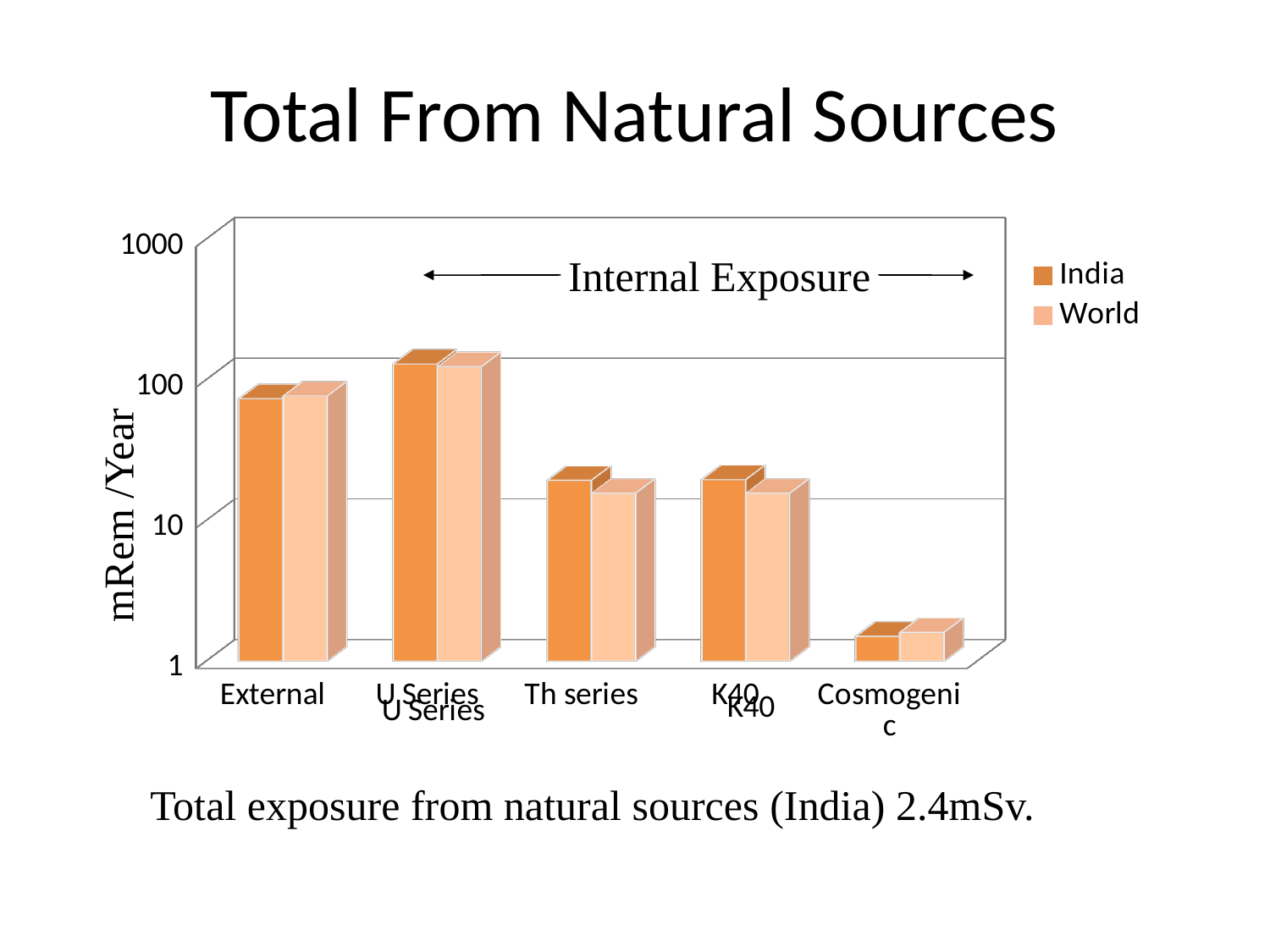
How many categories are shown on the x axis of the chart? 5 For the India series, which is larger: External or Th series? External Is the India value for U Series greater or less than 100? greater Is the India value for External greater or less than 100? less What kind of chart is shown on the slide? bar chart Which category has the highest value for the India series? U Series How many series does the chart's legend list? 2 Which category has the lowest value for the World series? Cosmogenic Is the World value for Th series greater or less than 10? greater What are the two series named in the chart's legend? India and World What is the label on the y axis of the chart? mRem /Year